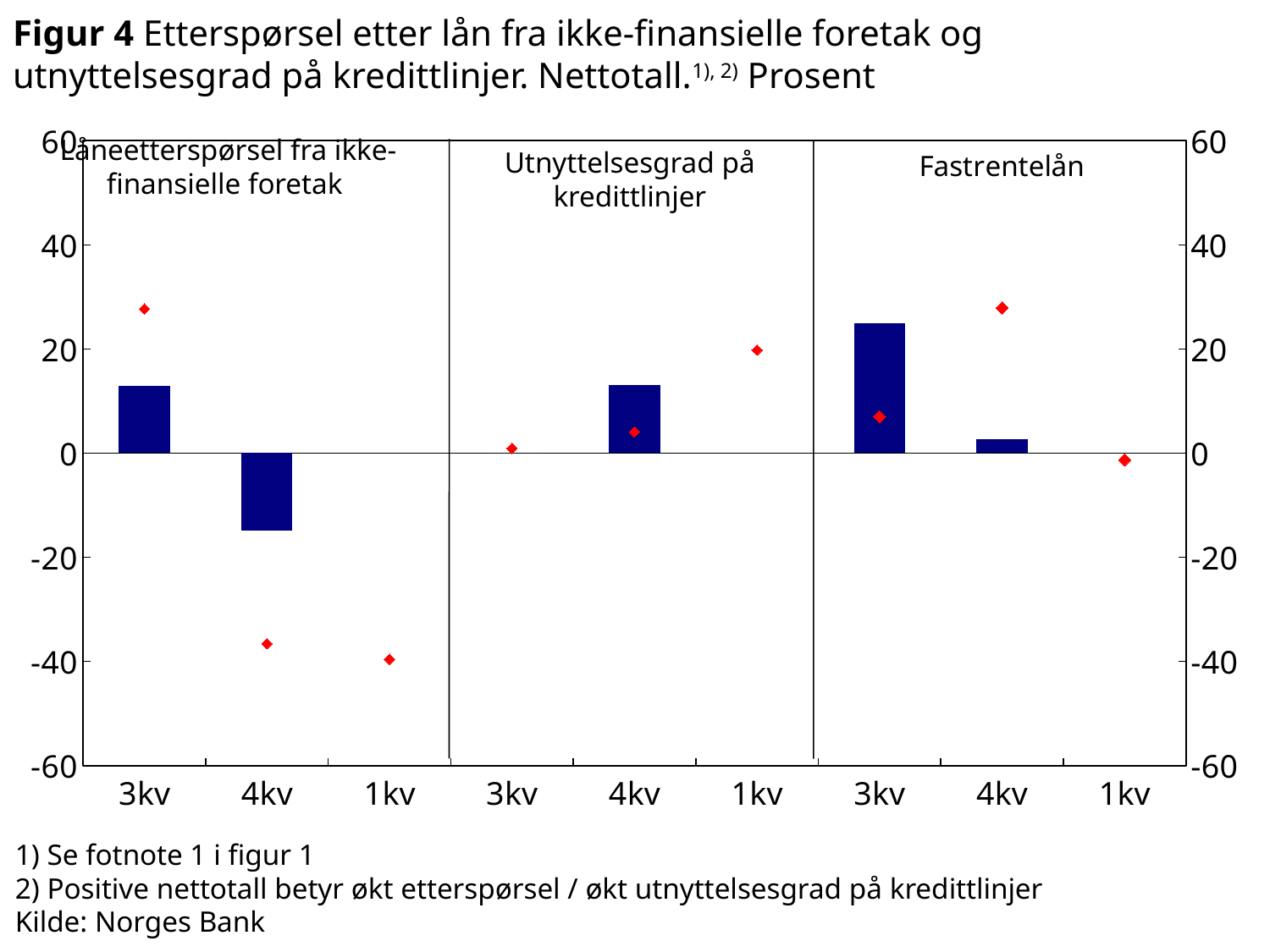
In the Låneetterspørsel fra ikke-finansielle foretak panel, is the red diamond for 4kv greater or less than -20? less In the Fastrentelån panel, which bar is taller, 3kv or 4kv? 3kv How many quarters are shown on the x axis of the Fastrentelån panel? 3 In the Fastrentelån panel, is the bar for 3kv greater or less than 20? greater What kind of chart is shown on the slide? combination bar and line chart (bars with red diamond markers) What is the title of the rightmost panel of the chart? Fastrentelån In the Låneetterspørsel fra ikke-finansielle foretak panel, is the bar for 3kv greater or less than 20? less How many panels does the chart have? 3 In the Utnyttelsesgrad på kredittlinjer panel, which quarter has the highest red diamond? 1kv In the Fastrentelån panel, which quarter has the lowest red diamond? 1kv